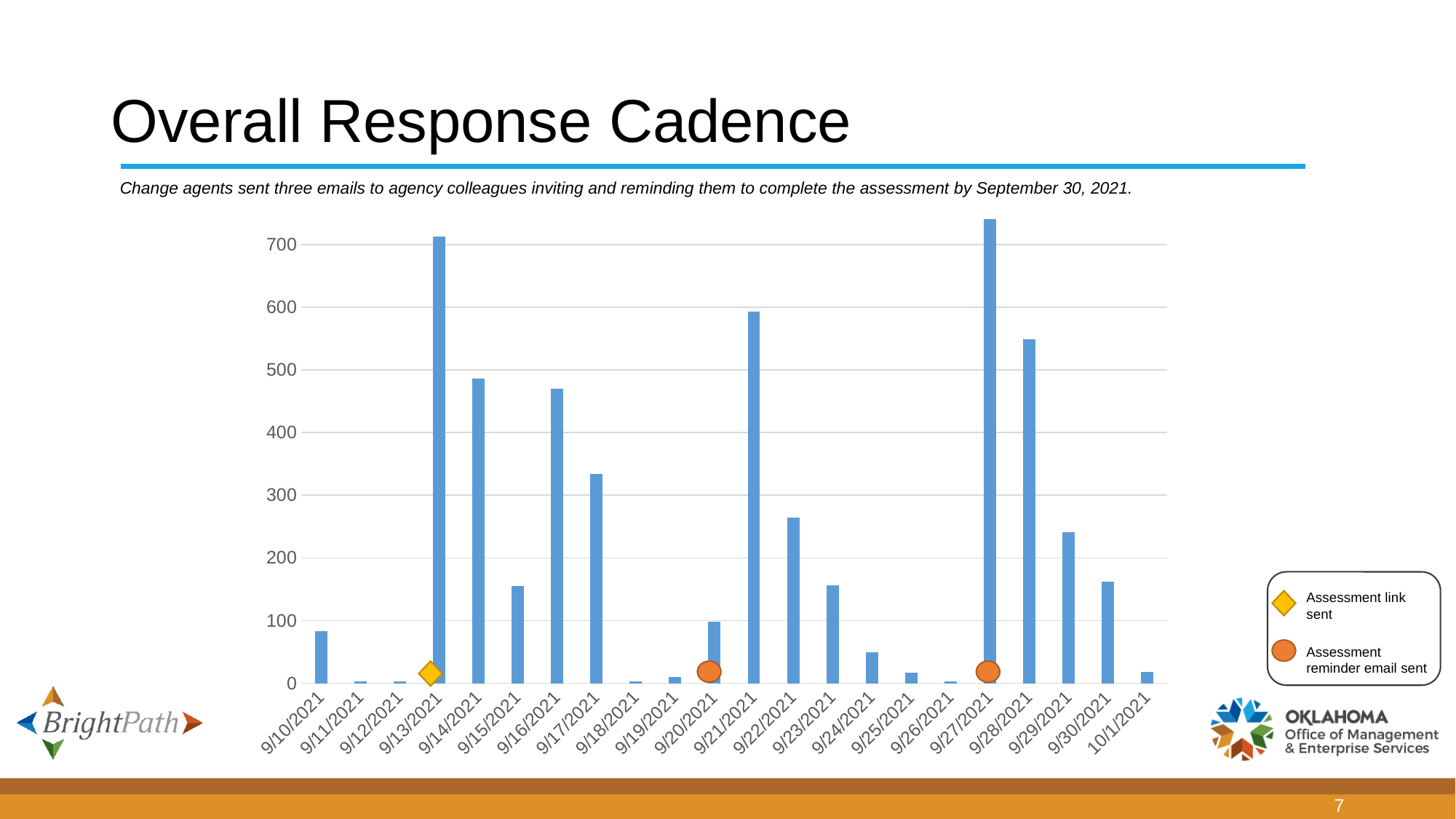
Is the value for 9/28/2021 greater or less than 500? greater How many dates are shown along the x axis of the chart? 22 What does the orange circle marker in the legend represent? Assessment reminder email sent Is the value for 9/13/2021 greater or less than 700? greater Which date has the larger value, 9/17/2021 or 9/22/2021? 9/17/2021 On which date does the chart mark the assessment link as sent? 9/13/2021 Is the value for 9/24/2021 greater or less than 100? less Which date has the larger value, 9/21/2021 or 9/28/2021? 9/21/2021 What kind of chart is shown on the slide? Bar chart Which date has the highest bar in the chart? 9/27/2021